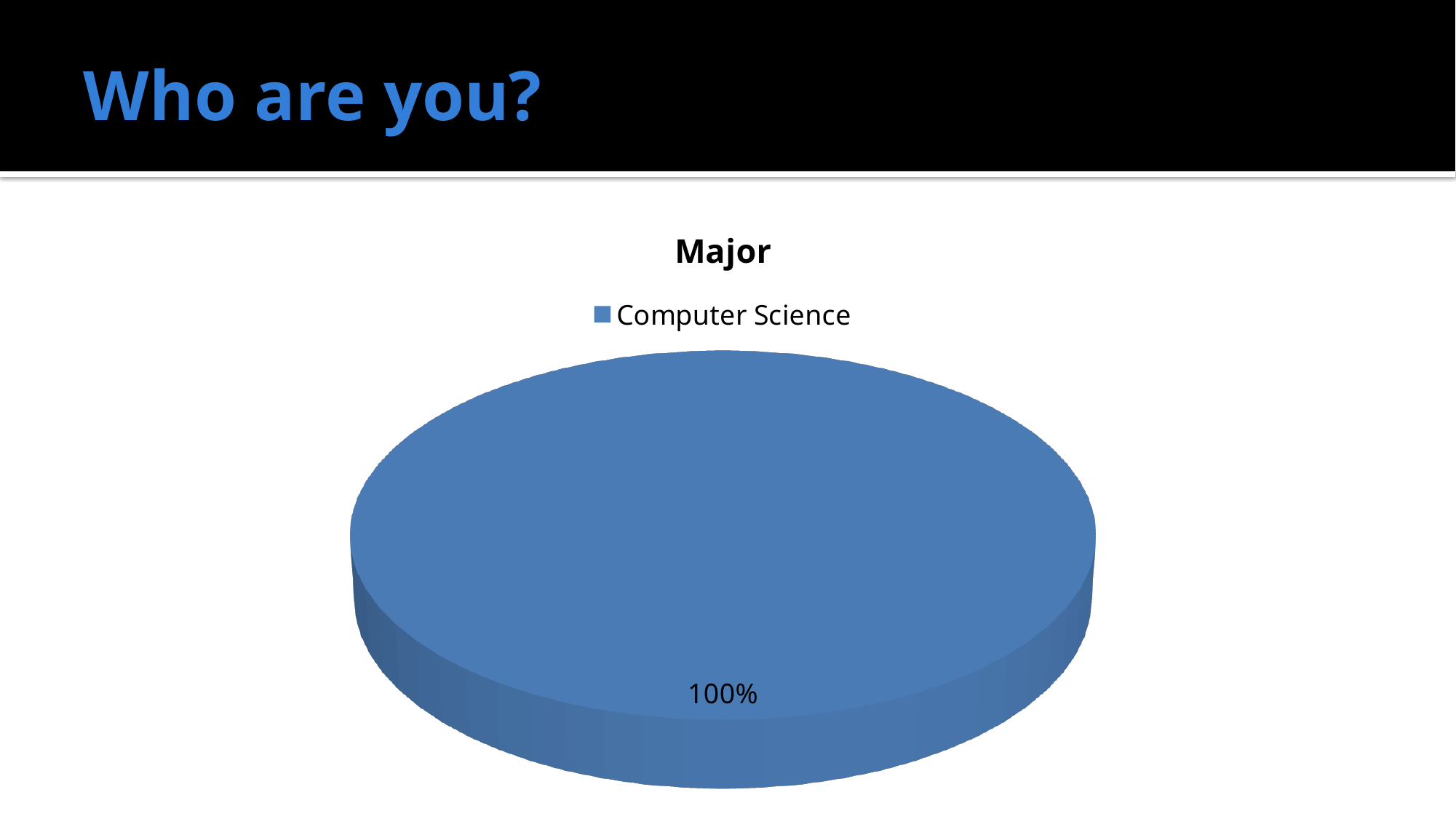
What is the title of the chart? Major What share of the pie does Computer Science represent? 100% Which category is listed in the legend? Computer Science How many entries does the legend list? 1 What is the data label shown on the Computer Science slice? 100% Which category has the largest share of the pie? Computer Science How many categories does the pie chart show? 1 What kind of chart is shown on the slide? pie chart